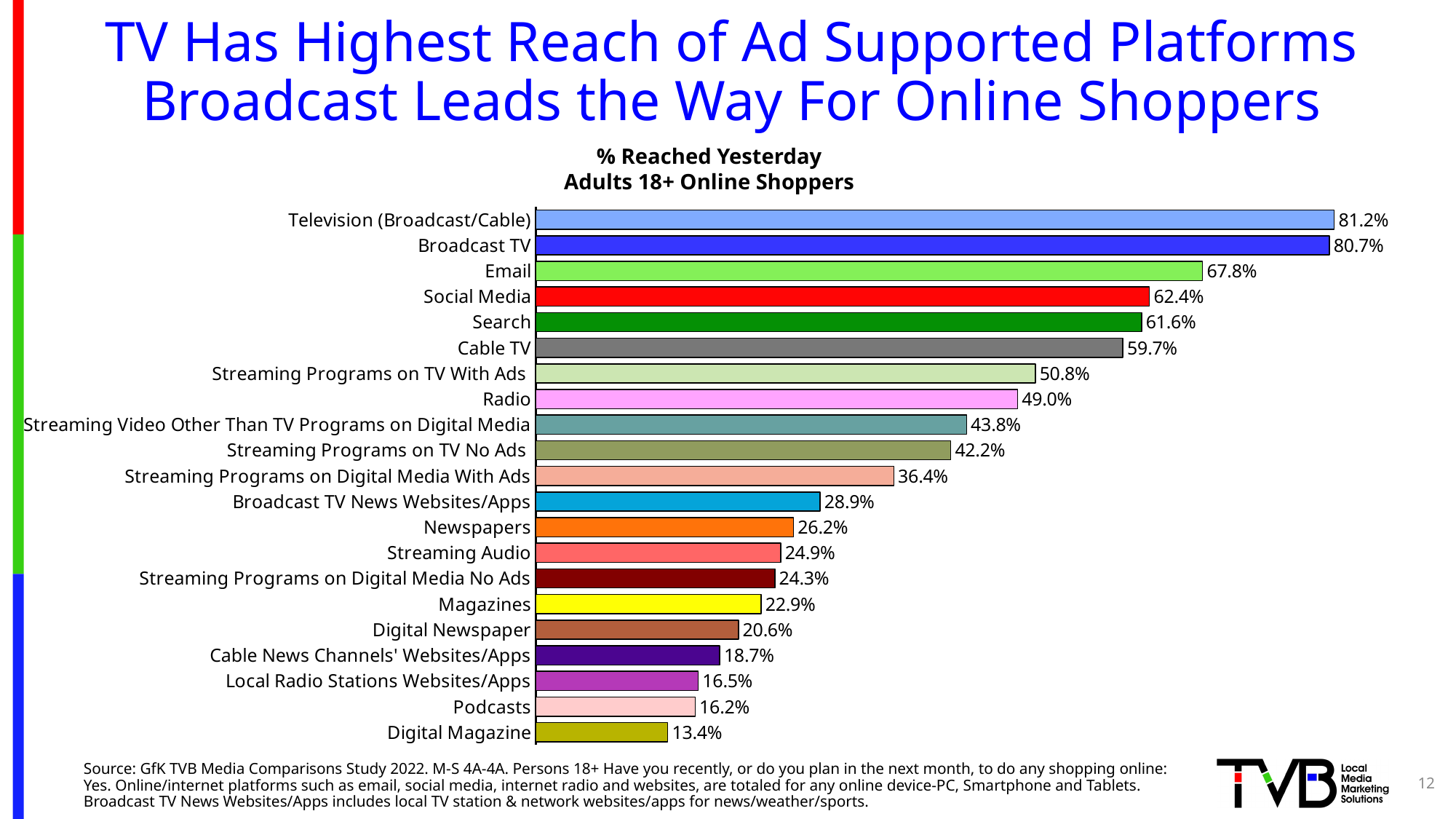
What is the value for Email? 67.8% What is the value for Podcasts? 16.2% What is the difference between the values for Broadcast TV and Cable TV? 21.0% Which category has the highest value? Television (Broadcast/Cable) How many categories are shown in the chart? 21 What is the title of the chart? % Reached Yesterday Adults 18+ Online Shoppers What is the difference between the values for Social Media and Search? 0.8% What is the value for Radio? 49.0% Which category has the lowest value? Digital Magazine What kind of chart is shown on the slide? Bar chart What is the value for Streaming Programs on TV With Ads? 50.8% Which is larger, the value for Newspapers or the value for Magazines? Newspapers